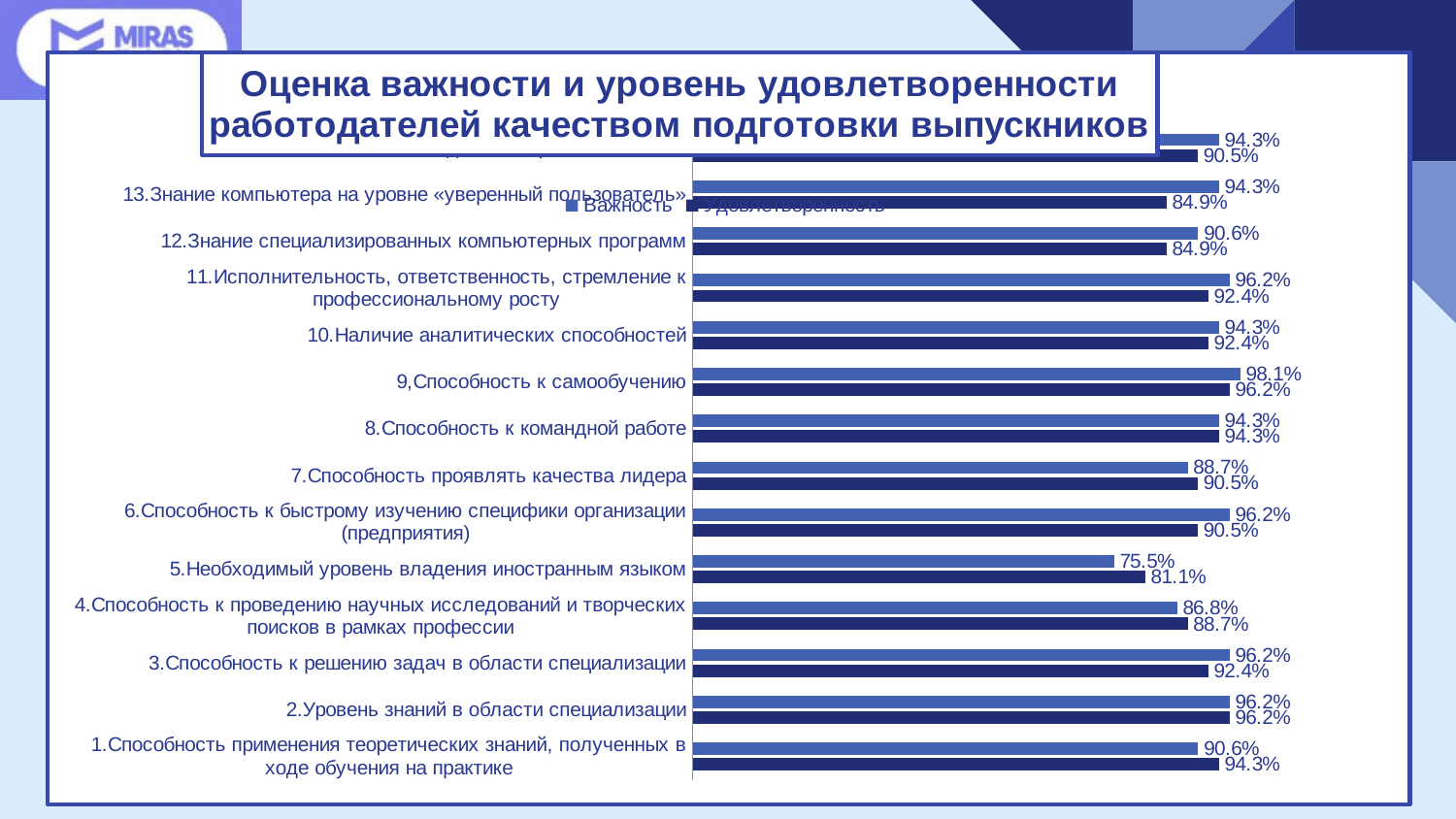
What is the Удовлетворенность value for "1.Способность применения теоретических знаний, полученных в ходе обучения на практике"? 94.3% For "12.Знание специализированных компьютерных программ", which is larger: Важность or Удовлетворенность? Важность How many series does the chart's legend list? 2 What is the Важность value for "13.Знание компьютера на уровне «уверенный пользователь»"? 94.3% What is the Удовлетворенность value for "5.Необходимый уровень владения иностранным языком"? 81.1% What is the title of the chart? Оценка важности и уровень удовлетворенности работодателей качеством подготовки выпускников Which category has the lowest Важность value? 5.Необходимый уровень владения иностранным языком What type of chart is shown on the slide? bar chart Which category has the highest Важность value? 9.Способность к самообучению For "7.Способность проявлять качества лидера", which is larger: Важность or Удовлетворенность? Удовлетворенность What is the Важность value for "9.Способность к самообучению"? 98.1% What is the difference between the Важность and Удовлетворенность values for "13.Знание компьютера на уровне «уверенный пользователь»"? 9.4%